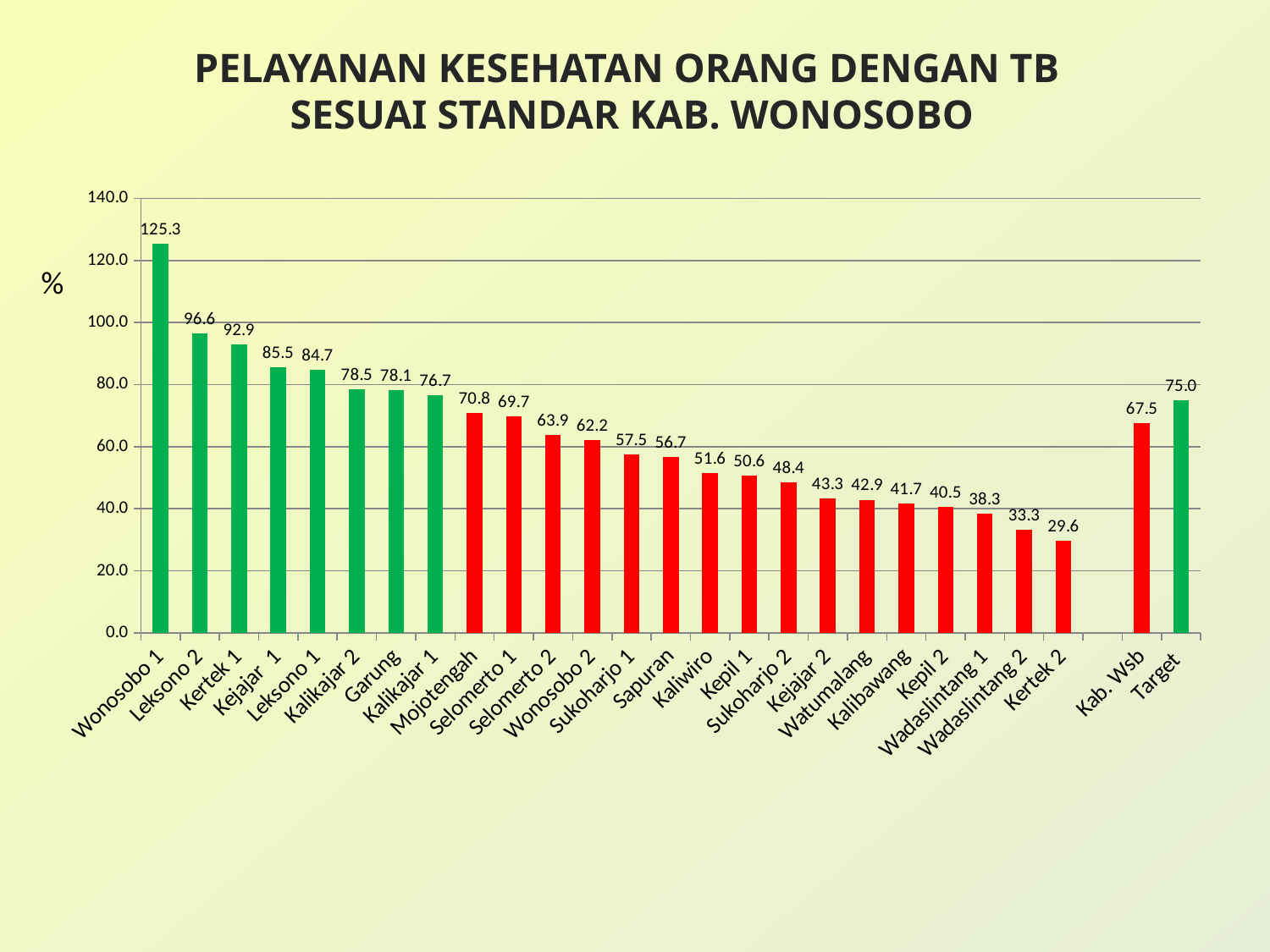
Which category has the highest value? Wonosobo 1 What is the difference between the values for Leksono 2 and Kertek 1? 3.7 What is the value for Wadaslintang 2? 33.3 What is the value for Wonosobo 1? 125.3 What is the difference between the values for Target and Kab. Wsb? 7.5 What is the value shown for Target? 75.0 Is the value for Kejajar 1 greater or less than 80.0? greater What type of chart is shown on the slide? Bar chart Which category has the lowest value? Kertek 2 Which is larger, the value for Mojotengah or the value for Selomerto 1? Mojotengah How many bars are plotted on the chart? 26 What is the value for Kab. Wsb? 67.5